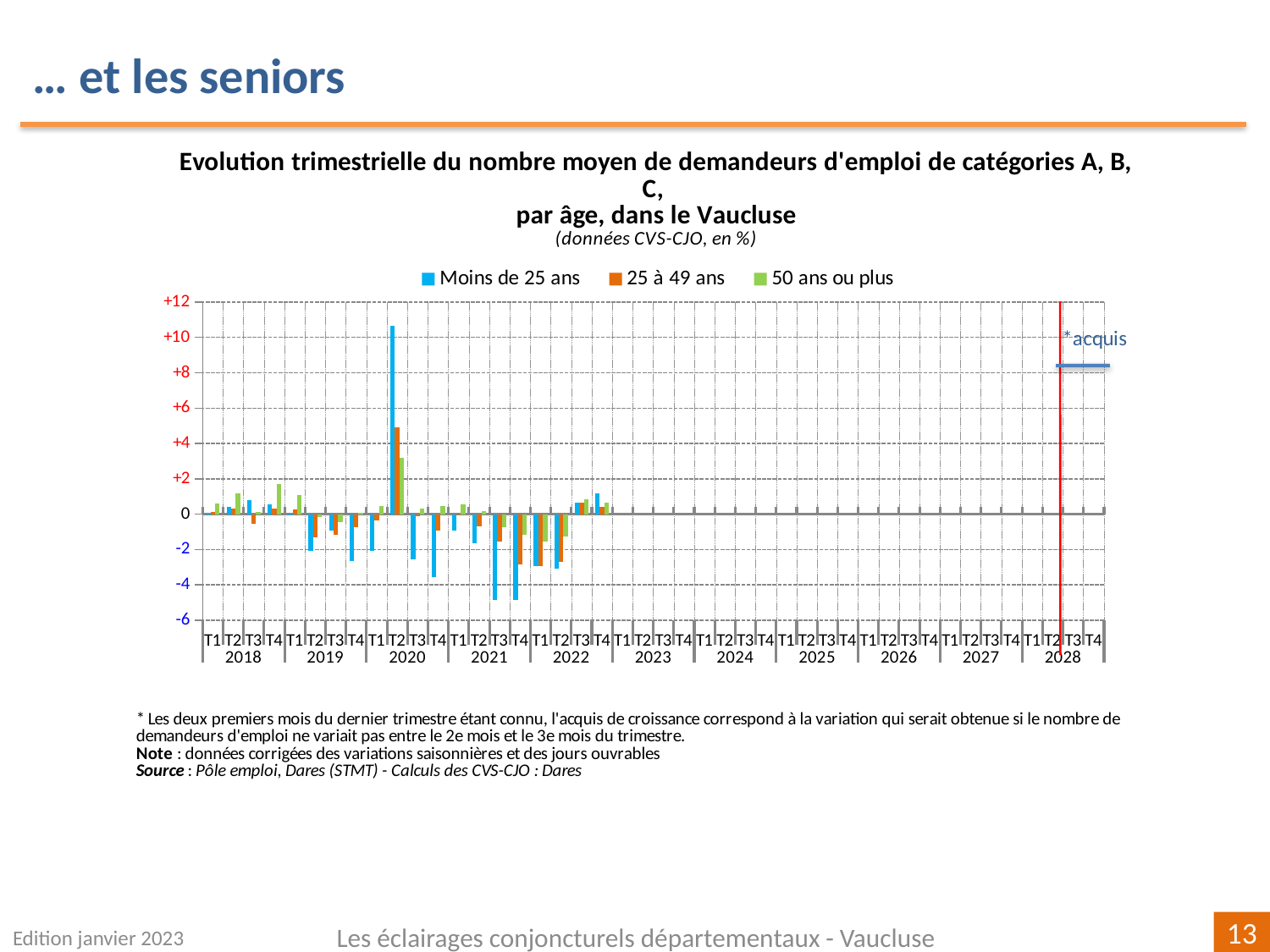
What kind of chart is shown on the slide? bar chart Is the value for 50 ans ou plus in T2 2020 greater or less than +2? greater In T2 2020, which is larger: the value for Moins de 25 ans or the value for 25 à 49 ans? Moins de 25 ans In T2 2020, which is larger: the value for 25 à 49 ans or the value for 50 ans ou plus? 25 à 49 ans How many years are labelled along the x axis? 11 How many series does the legend list? 3 Is the value for Moins de 25 ans in T2 2020 greater or less than +8? greater Is the value for 25 à 49 ans in T2 2020 greater or less than +4? greater Which colour represents the series '50 ans ou plus' in the legend? green What is the highest value shown on the vertical axis? +12 Which series has the highest bar in T2 2020? Moins de 25 ans